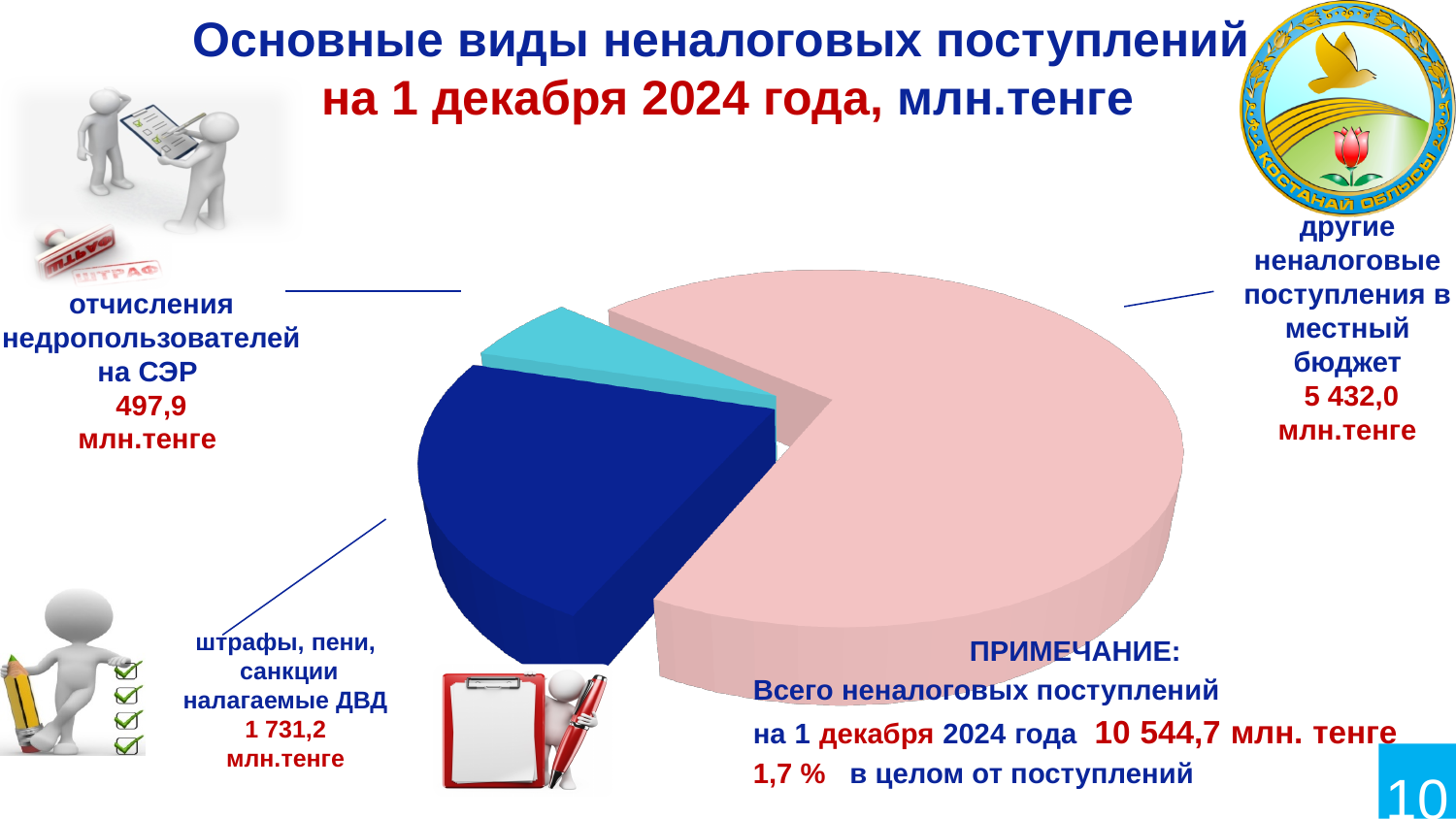
What is the difference between другие неналоговые поступления в местный бюджет and штрафы, пени, санкции налагаемые ДВД? 3 700,8 млн.тенге Which category has the largest slice of the pie? другие неналоговые поступления в местный бюджет What is the value for штрафы, пени, санкции налагаемые ДВД? 1 731,2 млн.тенге What kind of chart is shown on the slide? pie chart What is the value for другие неналоговые поступления в местный бюджет? 5 432,0 млн.тенге What is the value for отчисления недропользователей на СЭР? 497,9 млн.тенге Which category has the smallest slice of the pie? отчисления недропользователей на СЭР How many slices does the pie chart have? 3 What is the title of the slide's chart? Основные виды неналоговых поступлений на 1 декабря 2024 года, млн.тенге What colour is the largest slice of the pie chart? pink Which is larger: штрафы, пени, санкции налагаемые ДВД or отчисления недропользователей на СЭР? штрафы, пени, санкции налагаемые ДВД What is the difference between штрафы, пени, санкции налагаемые ДВД and отчисления недропользователей на СЭР? 1 233,3 млн.тенге